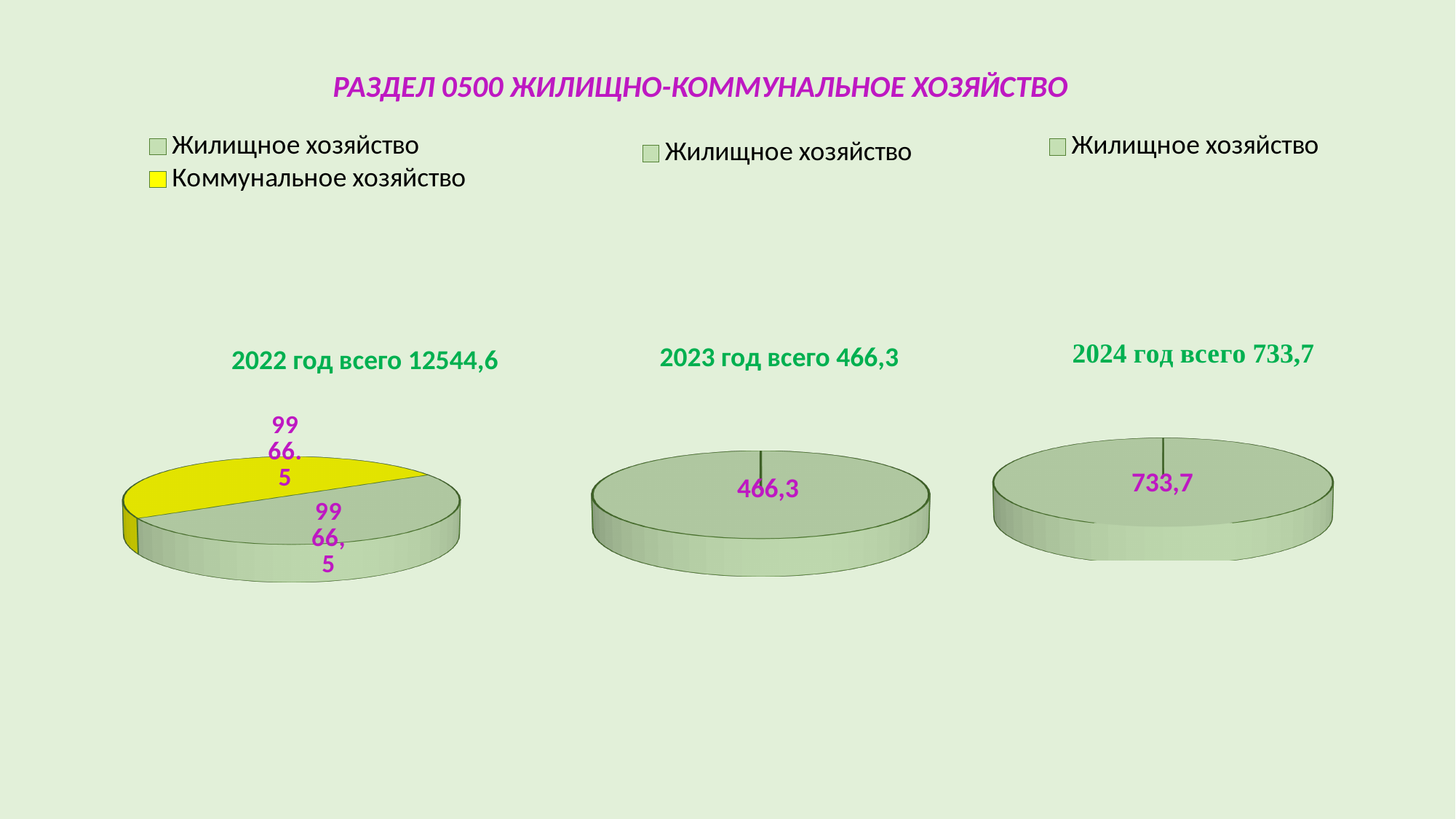
What kind of chart is the '2022 год всего 12544,6' chart? pie chart Which year's chart shows the highest total? 2022 Which is larger: the total for 2024 or the total for 2023? 2024 In the '2022 год всего 12544,6' chart, what colour is the Коммунальное хозяйство slice? yellow In the '2023 год всего 466,3' chart, what is the value for Жилищное хозяйство? 466,3 How many entries does the legend of the '2023 год всего 466,3' chart list? 1 According to the chart titles, what is the total for 2022? 12544,6 In the '2024 год всего 733,7' chart, what is the value for Жилищное хозяйство? 733,7 How many slices does the '2022 год всего 12544,6' pie chart have? 2 What is the difference between the 2024 total (733,7) and the 2023 total (466,3)? 267,4 In the '2023 год всего 466,3' chart, what share of the pie does Жилищное хозяйство take? 100% How many entries does the legend of the '2022 год всего 12544,6' chart list? 2